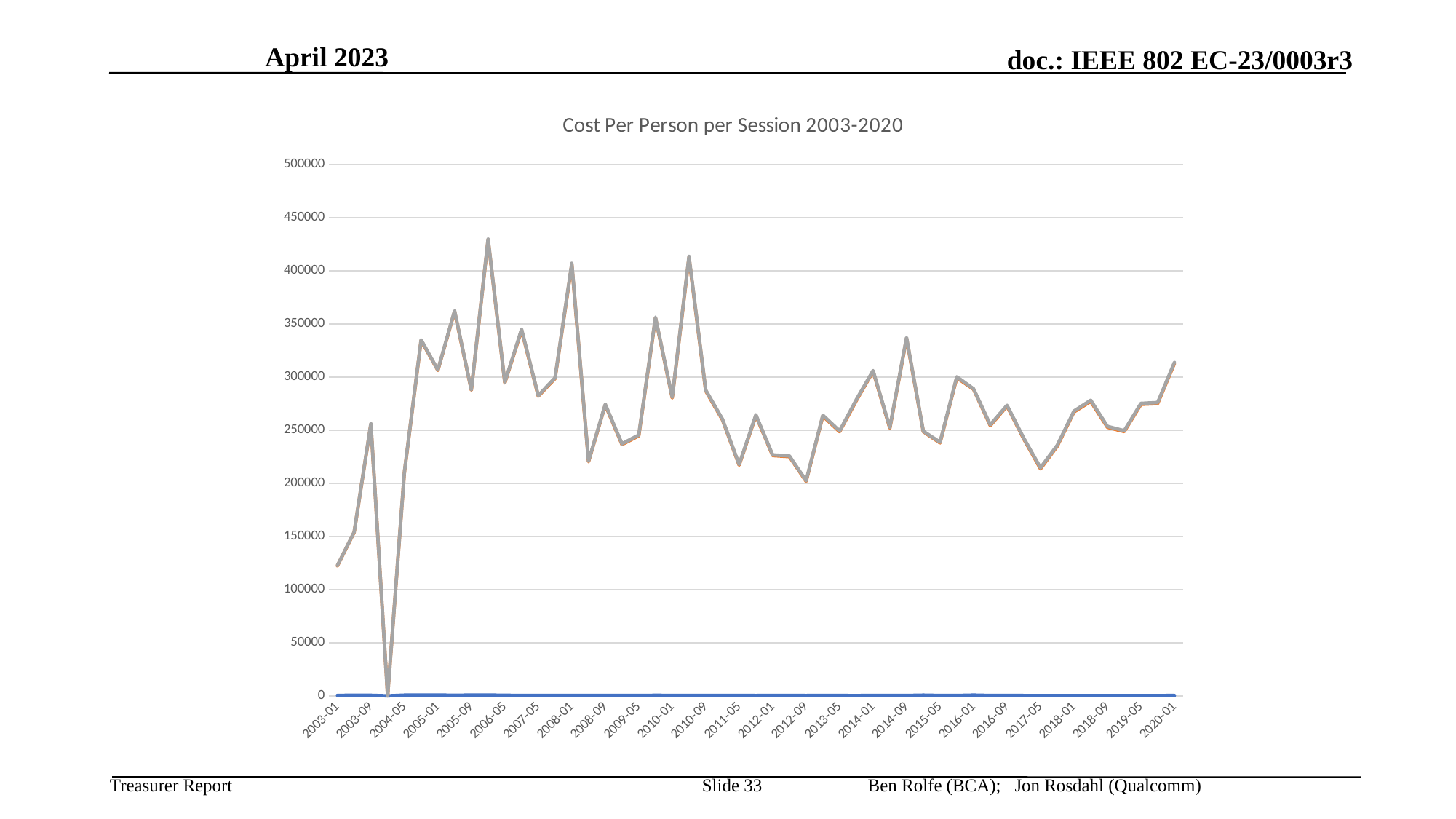
What is the highest value shown on the vertical axis? 500000 What kind of chart is shown on the slide? line chart What is the title of the chart? Cost Per Person per Session 2003-2020 Which is larger, the value for 2008-01 or the value for 2012-09? 2008-01 Is the value for 2012-09 greater or less than 250000? less Is the value for 2003-01 greater or less than 150000? less Is the value for 2014-09 greater or less than 300000? greater Which is larger, the value for 2003-01 or the value for 2020-01? 2020-01